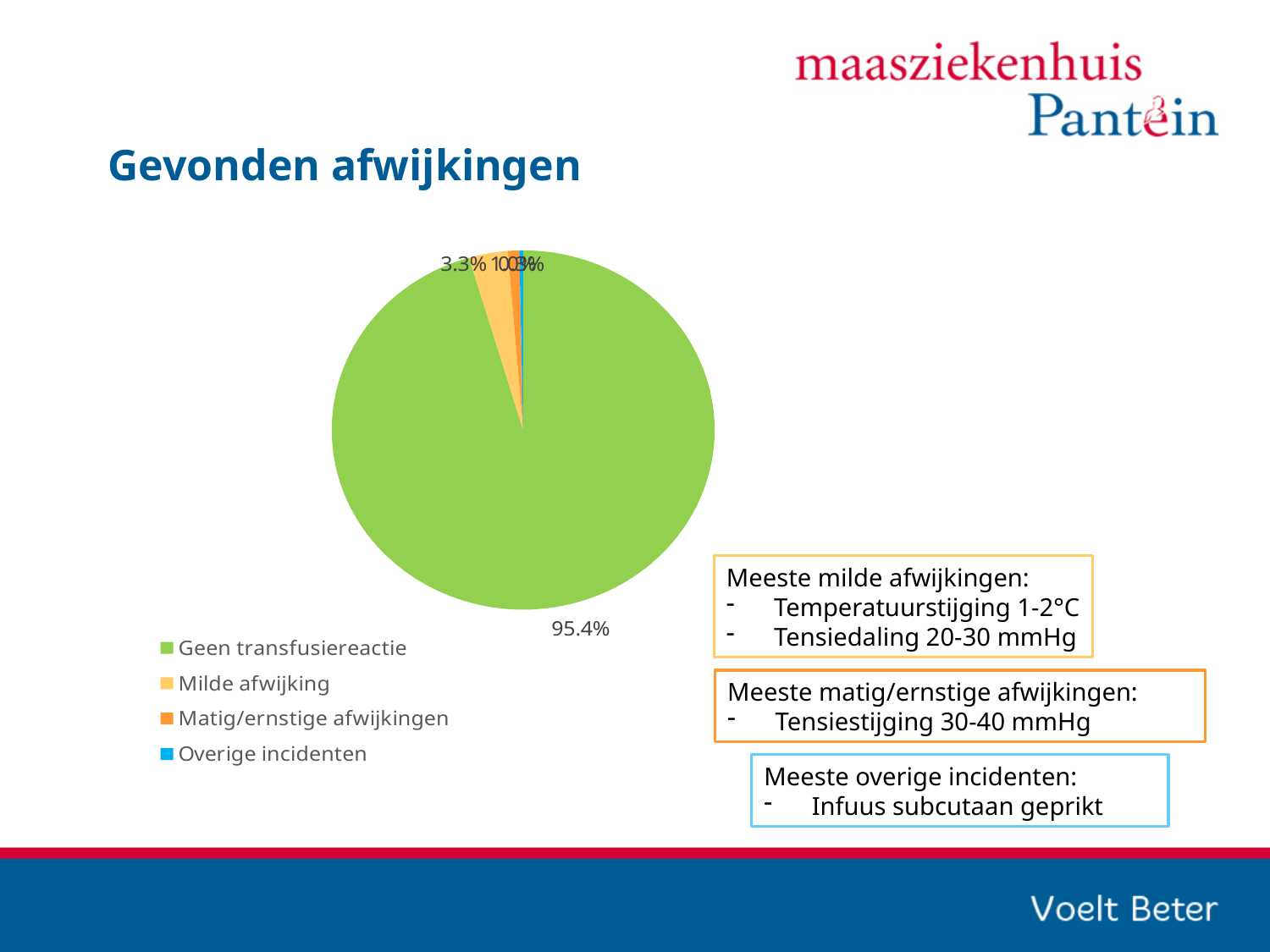
What is the difference in percentage points between the Geen transfusiereactie slice and the Milde afwijking slice? 92.1 percentage points Which category has the largest slice of the pie chart? Geen transfusiereactie How many categories does the pie chart show? 4 What percentage of the pie chart is labelled for Milde afwijking? 3.3% Which is larger in the pie chart, Milde afwijking or Overige incidenten? Milde afwijking How many entries does the legend of the pie chart list? 4 What colour represents Geen transfusiereactie in the pie chart? Green What percentage of the pie chart is labelled for Geen transfusiereactie? 95.4% What is the title of the slide containing the pie chart? Gevonden afwijkingen Which is larger in the pie chart, Geen transfusiereactie or Milde afwijking? Geen transfusiereactie What kind of chart is shown on the slide? Pie chart